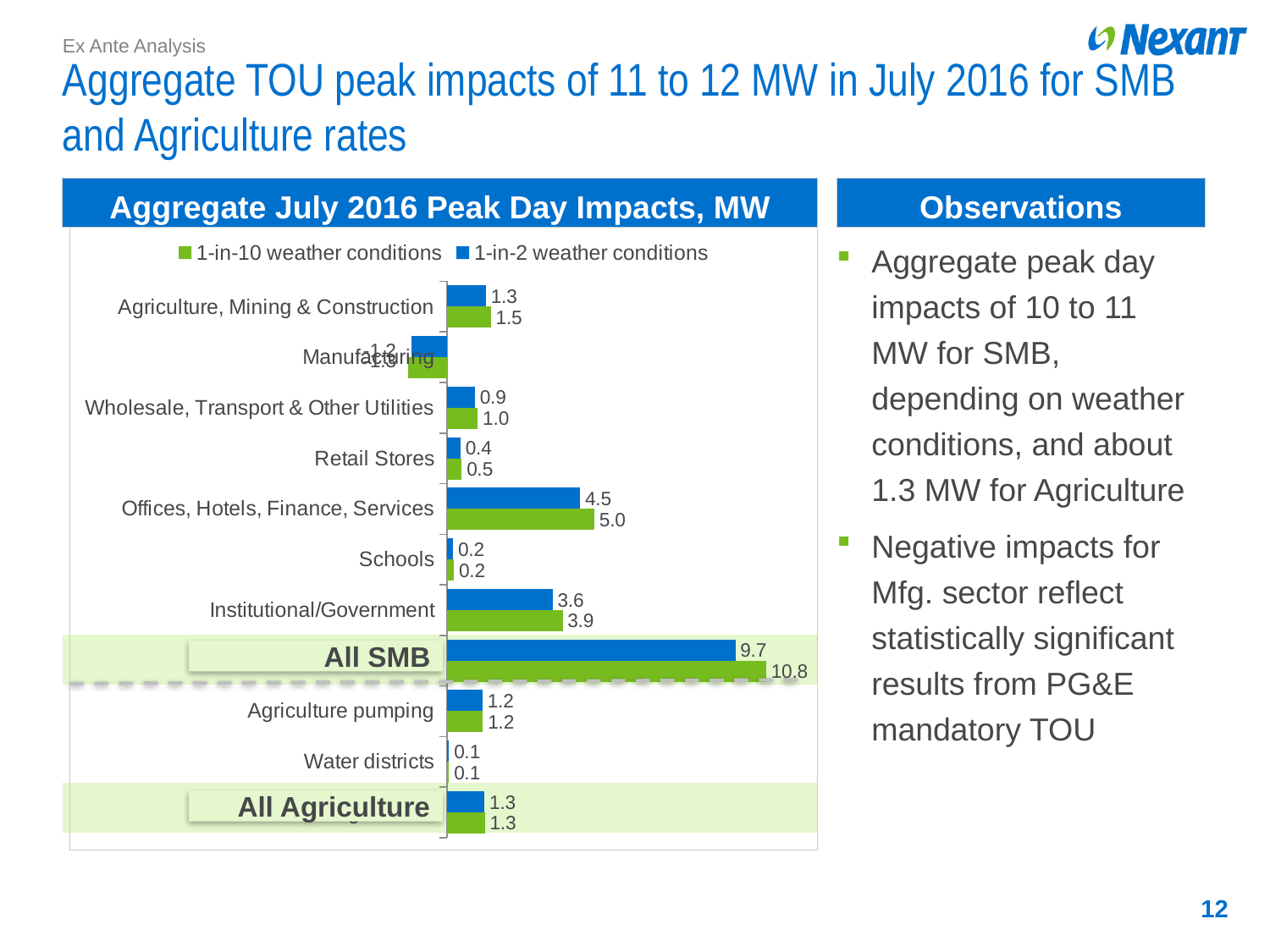
How many categories are shown on the chart? 11 Which is larger: the 1-in-10 weather conditions value for Institutional/Government or for Offices, Hotels, Finance, Services? Offices, Hotels, Finance, Services Which category has the highest value under 1-in-2 weather conditions? All SMB What type of chart is shown on the slide? bar chart What is the value for Institutional/Government under 1-in-10 weather conditions? 3.9 What is the difference between the 1-in-10 and 1-in-2 weather condition values for All SMB? 1.1 What is the value for Offices, Hotels, Finance, Services under 1-in-2 weather conditions? 4.5 Which colour represents the 1-in-2 weather conditions series? blue How many series does the chart legend list? 2 What is the title of the chart? Aggregate July 2016 Peak Day Impacts, MW Which category has the lowest value under 1-in-10 weather conditions? Manufacturing What is the value for All SMB under 1-in-10 weather conditions? 10.8